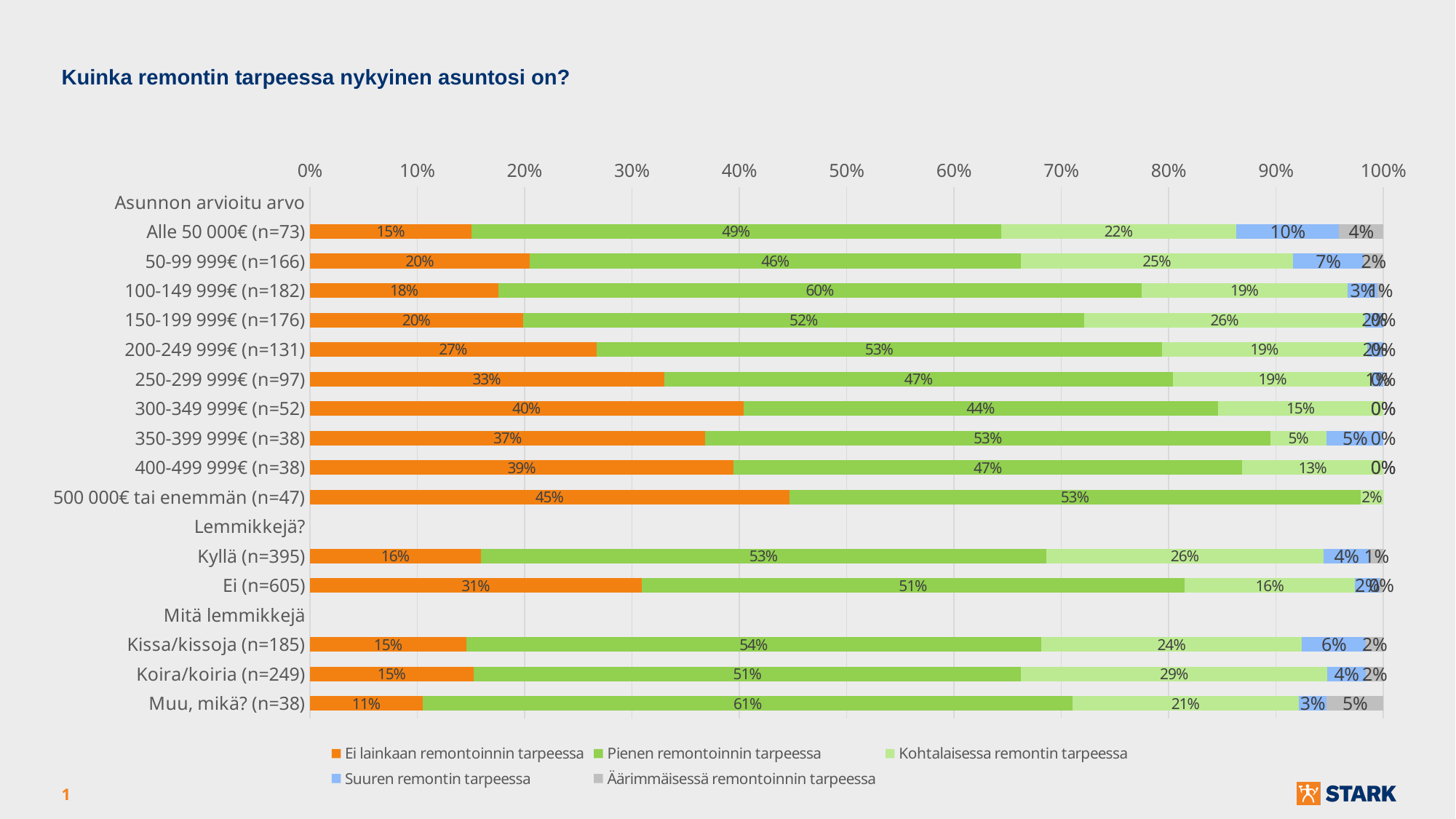
What is the value of 'Pienen remontoinnin tarpeessa' for 'Muu, mikä? (n=38)'? 61% What is the value of 'Äärimmäisessä remontoinnin tarpeessa' for 'Muu, mikä? (n=38)'? 5% What kind of chart is shown on the slide? Stacked bar chart What is the value of 'Ei lainkaan remontoinnin tarpeessa' for 'Alle 50 000€ (n=73)'? 15% What is the difference in 'Ei lainkaan remontoinnin tarpeessa' between 'Ei (n=605)' and 'Kyllä (n=395)'? 15 percentage points What is the value of 'Suuren remontin tarpeessa' for 'Alle 50 000€ (n=73)'? 10% Which category has the lowest value for 'Ei lainkaan remontoinnin tarpeessa'? Muu, mikä? (n=38) Which has a larger 'Kohtalaisessa remontin tarpeessa' value, 'Kissa/kissoja (n=185)' or 'Koira/koiria (n=249)'? Koira/koiria (n=249) What is the title of the chart? Kuinka remontin tarpeessa nykyinen asuntosi on? Which category has the highest value for 'Ei lainkaan remontoinnin tarpeessa'? 500 000€ tai enemmän (n=47) What is the value of 'Kohtalaisessa remontin tarpeessa' for 'Koira/koiria (n=249)'? 29% How many series does the legend list? 5